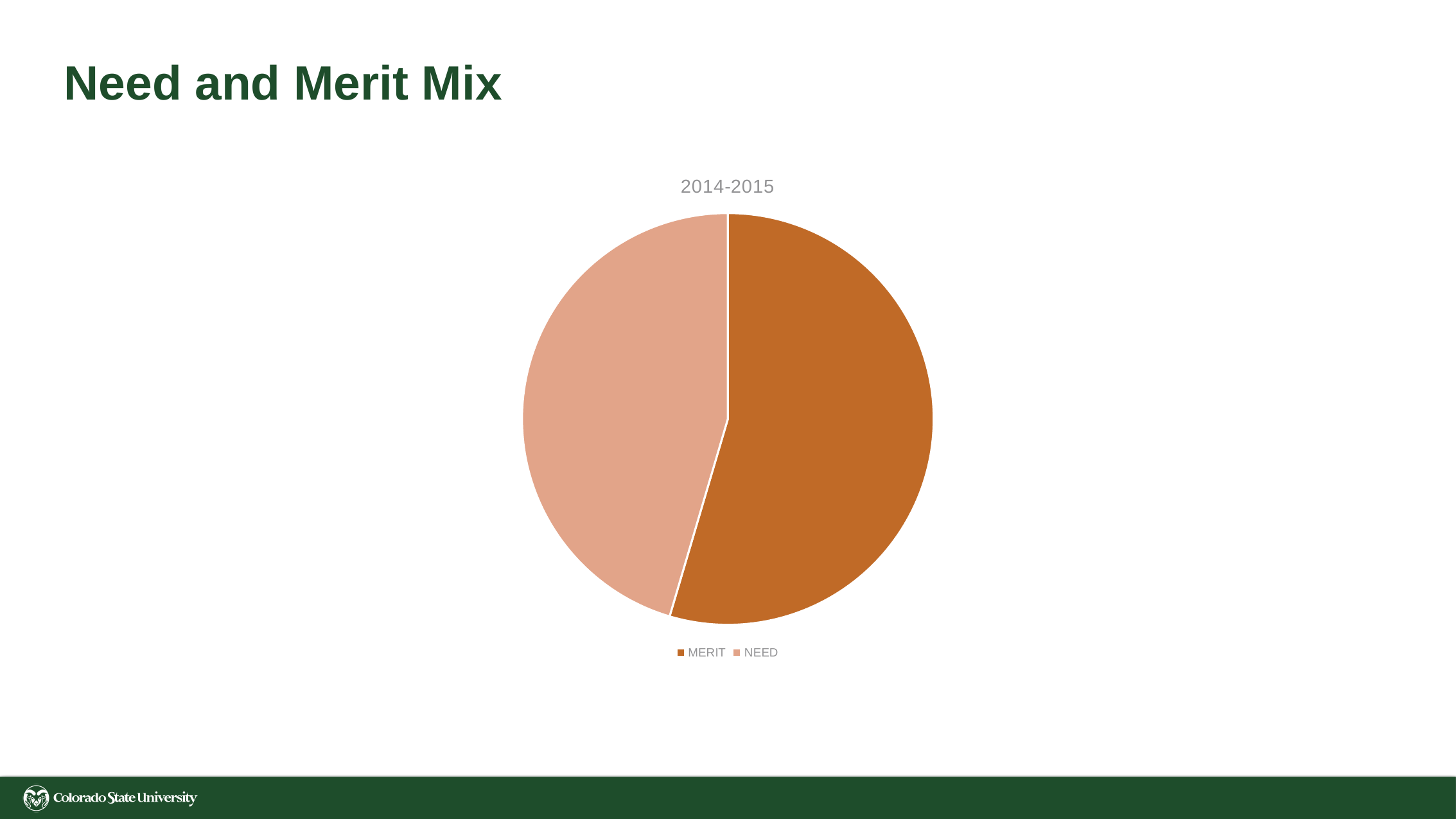
Which category has the smallest slice in the pie chart? NEED Is the MERIT slice more or less than half of the pie? more What is the title of the pie chart? 2014-2015 How many slices does the pie chart have? 2 Is the NEED slice more or less than half of the pie? less What are the two categories shown in the pie chart's legend? MERIT and NEED Which category has the largest slice in the pie chart? MERIT How many entries does the legend of the pie chart list? 2 Which slice is larger, MERIT or NEED? MERIT What kind of chart is shown on the slide? pie chart